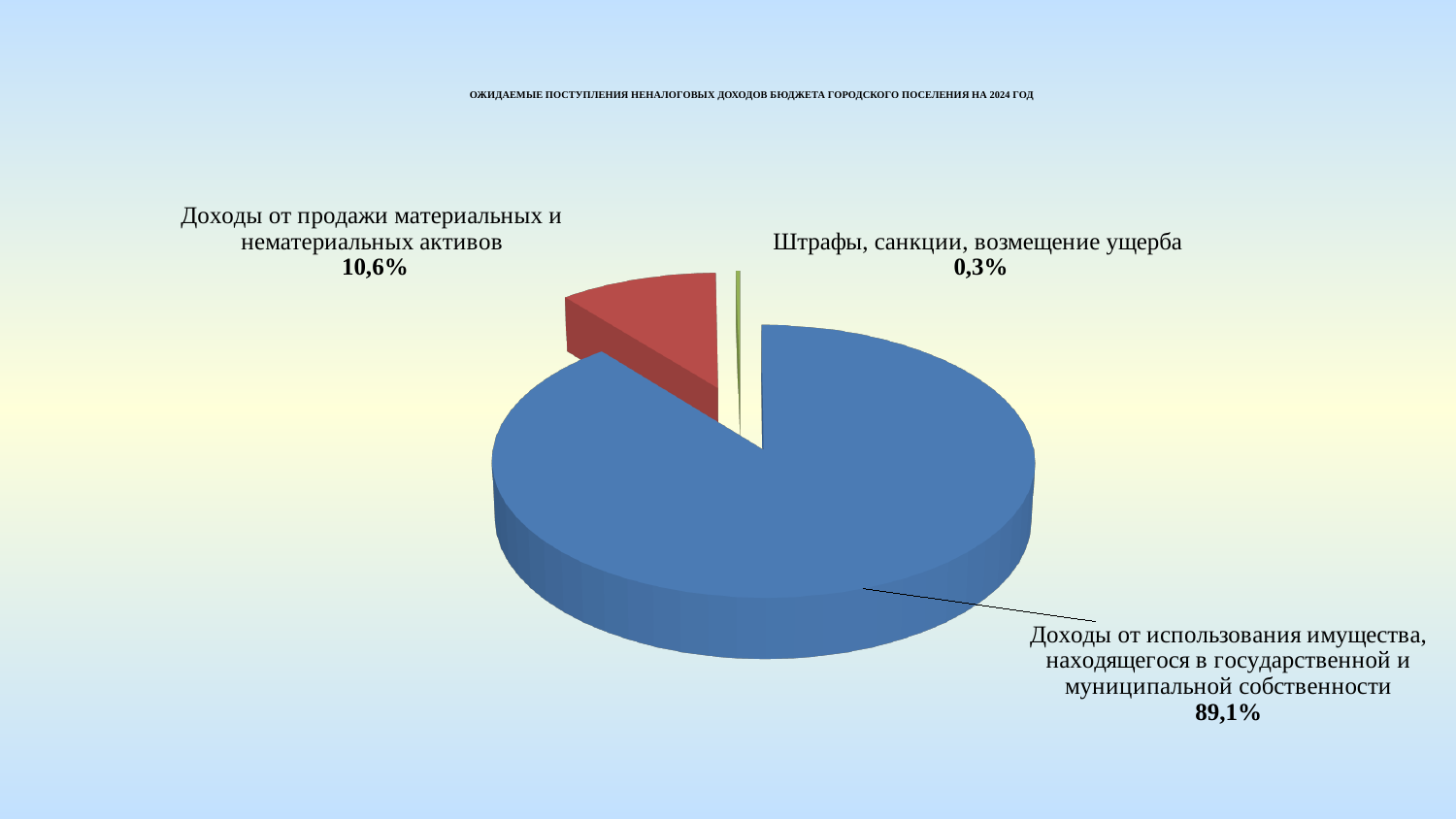
What is the difference in percentage points between "Доходы от продажи материальных и нематериальных активов" and "Штрафы, санкции, возмещение ущерба"? 10,3 Which category has the smallest slice of the pie? Штрафы, санкции, возмещение ущерба Which category has the largest slice of the pie? Доходы от использования имущества, находящегося в государственной и муниципальной собственности What is the difference in percentage points between the largest slice and "Доходы от продажи материальных и нематериальных активов"? 78,5 What share of the pie is labelled for "Доходы от продажи материальных и нематериальных активов"? 10,6% What is the title of the chart on the slide? ОЖИДАЕМЫЕ ПОСТУПЛЕНИЯ НЕНАЛОГОВЫХ ДОХОДОВ БЮДЖЕТА ГОРОДСКОГО ПОСЕЛЕНИЯ НА 2024 ГОД What share of the pie is labelled for "Доходы от использования имущества, находящегося в государственной и муниципальной собственности"? 89,1% How many slices does the pie chart have? 3 Which is larger: the share for "Доходы от продажи материальных и нематериальных активов" or the share for "Штрафы, санкции, возмещение ущерба"? Доходы от продажи материальных и нематериальных активов What share of the pie is labelled for "Штрафы, санкции, возмещение ущерба"? 0,3% What colour is the slice for "Доходы от продажи материальных и нематериальных активов"? Red What type of chart is shown on the slide? Pie chart